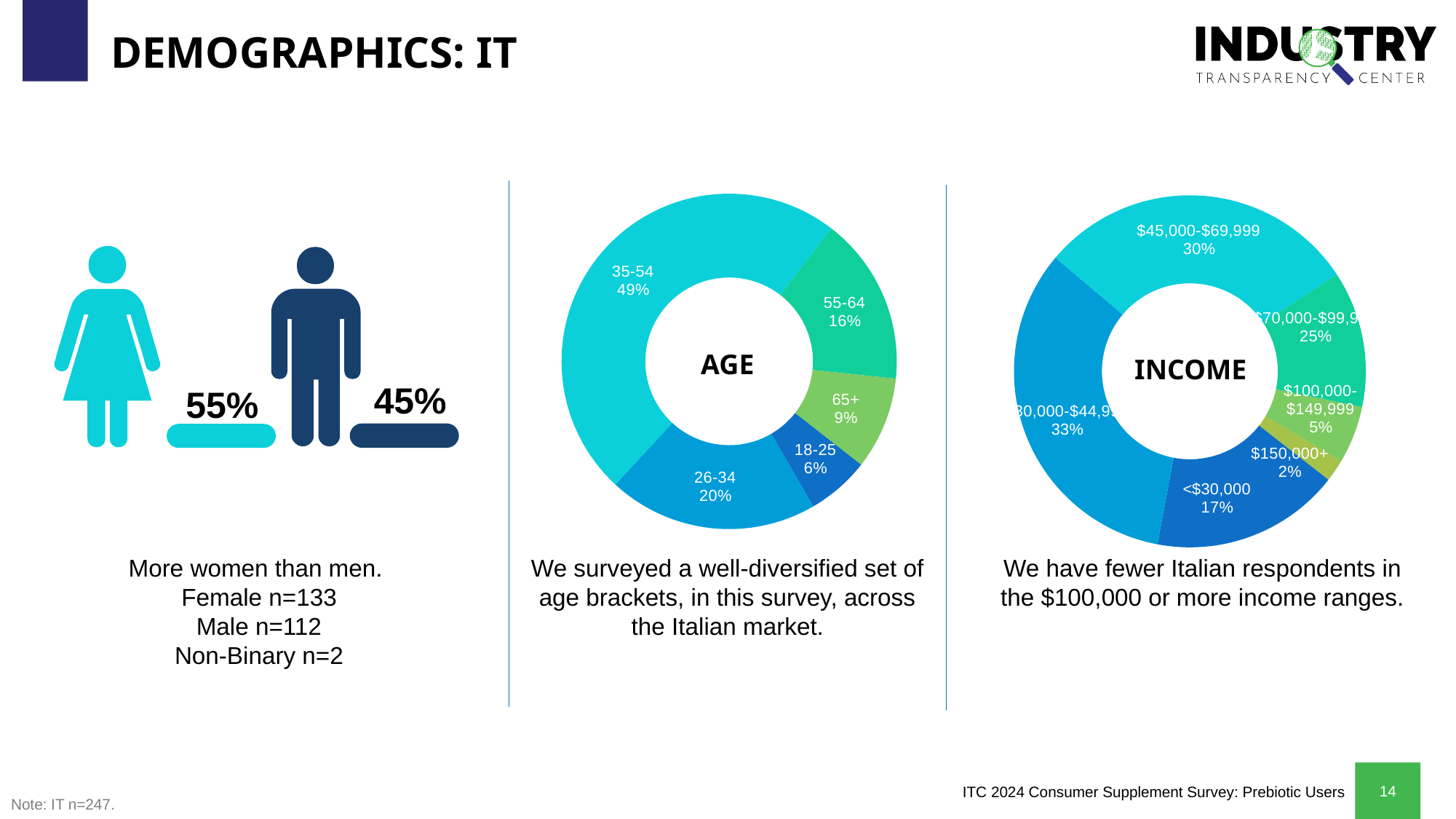
How many income ranges are shown in the INCOME chart? 6 What kind of chart is the AGE chart? Donut (pie) chart In the AGE chart, what is the difference between the 55-64 share and the 65+ share? 7% In the INCOME chart, what share of respondents earn $45,000-$69,999? 30% In the AGE chart, which is larger: the 26-34 share or the 55-64 share? 26-34 In the INCOME chart, which income range has the smallest share? $150,000+ In the AGE chart, what share of respondents are aged 35-54? 49% In the AGE chart, what share of respondents are aged 26-34? 20% How many age brackets are shown in the AGE chart? 5 In the AGE chart, which age bracket has the largest share? 35-54 In the INCOME chart, what share of respondents earn less than $30,000? 17% In the AGE chart, which age bracket has the smallest share? 18-25